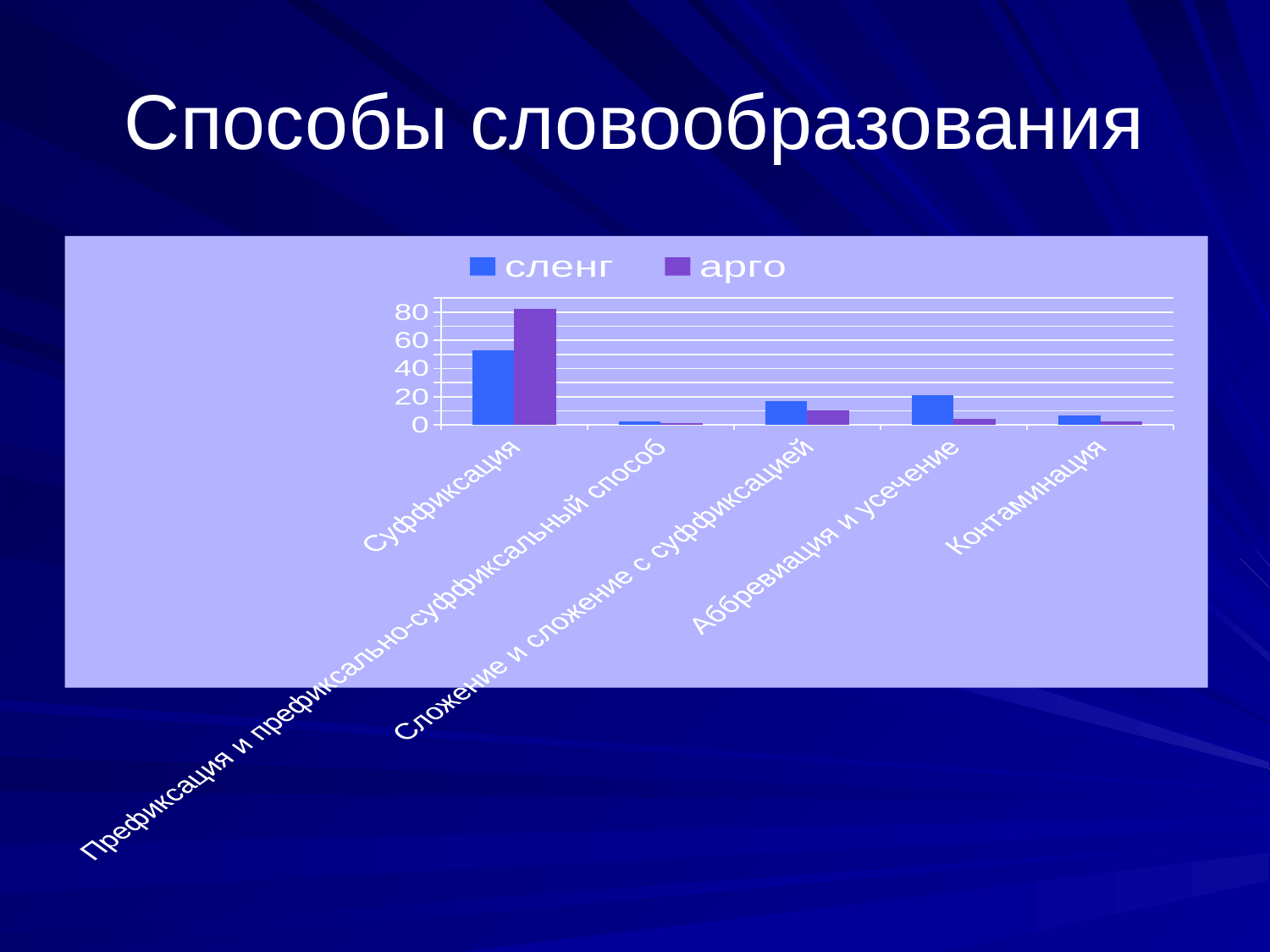
How many categories are shown on the x axis? 5 Which category has the lowest value for сленг? Префиксация и префиксально-суффиксальный способ Is the value for сленг in Аббревиация и усечение greater or less than 40? less How many series does the legend list? 2 Is the value for сленг in Суффиксация greater or less than 40? greater Which category has the highest value for арго? Суффиксация What kind of chart is shown on the slide? bar chart For Аббревиация и усечение, which series has the larger value, сленг or арго? сленг Is the value for арго in Суффиксация greater or less than 60? greater For Суффиксация, which series has the larger value, сленг or арго? арго Which category has the highest value for сленг? Суффиксация What are the two series named in the legend? сленг and арго